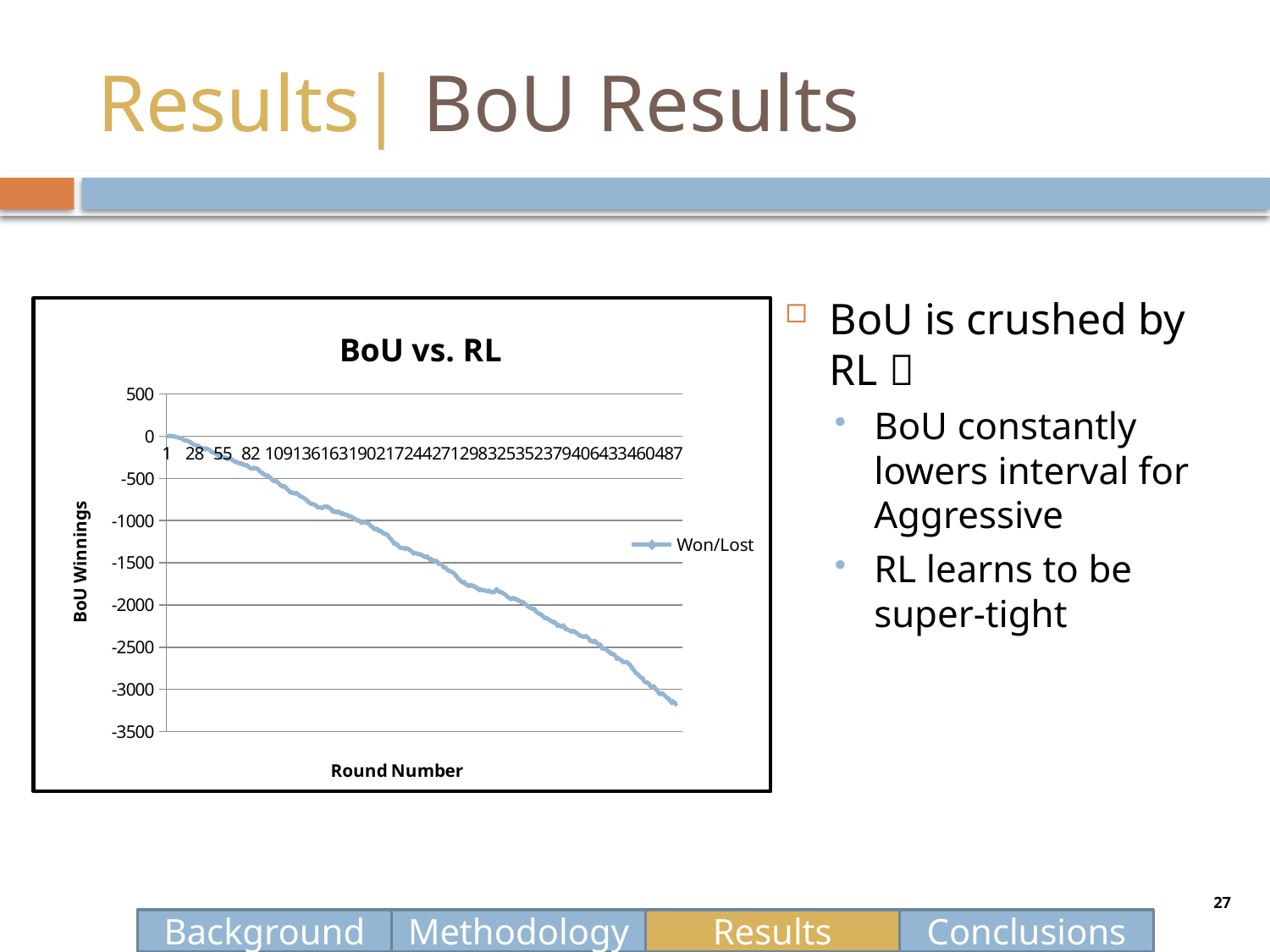
Which is larger, the Won/Lost value at round 28 or at round 460? round 28 How many series does the chart legend list? 1 Is the Won/Lost value at round 487 greater or less than -3500? greater What is the title of the chart? BoU vs. RL Is the Won/Lost value at round 406 greater or less than -2000? less Is the Won/Lost value at round 298 greater or less than -1500? less What is the lowest value shown on the vertical axis? -3500 Do the Won/Lost values rise or fall as the round number increases? fall What is the name of the series shown in the legend? Won/Lost What kind of chart is shown on the slide? line chart